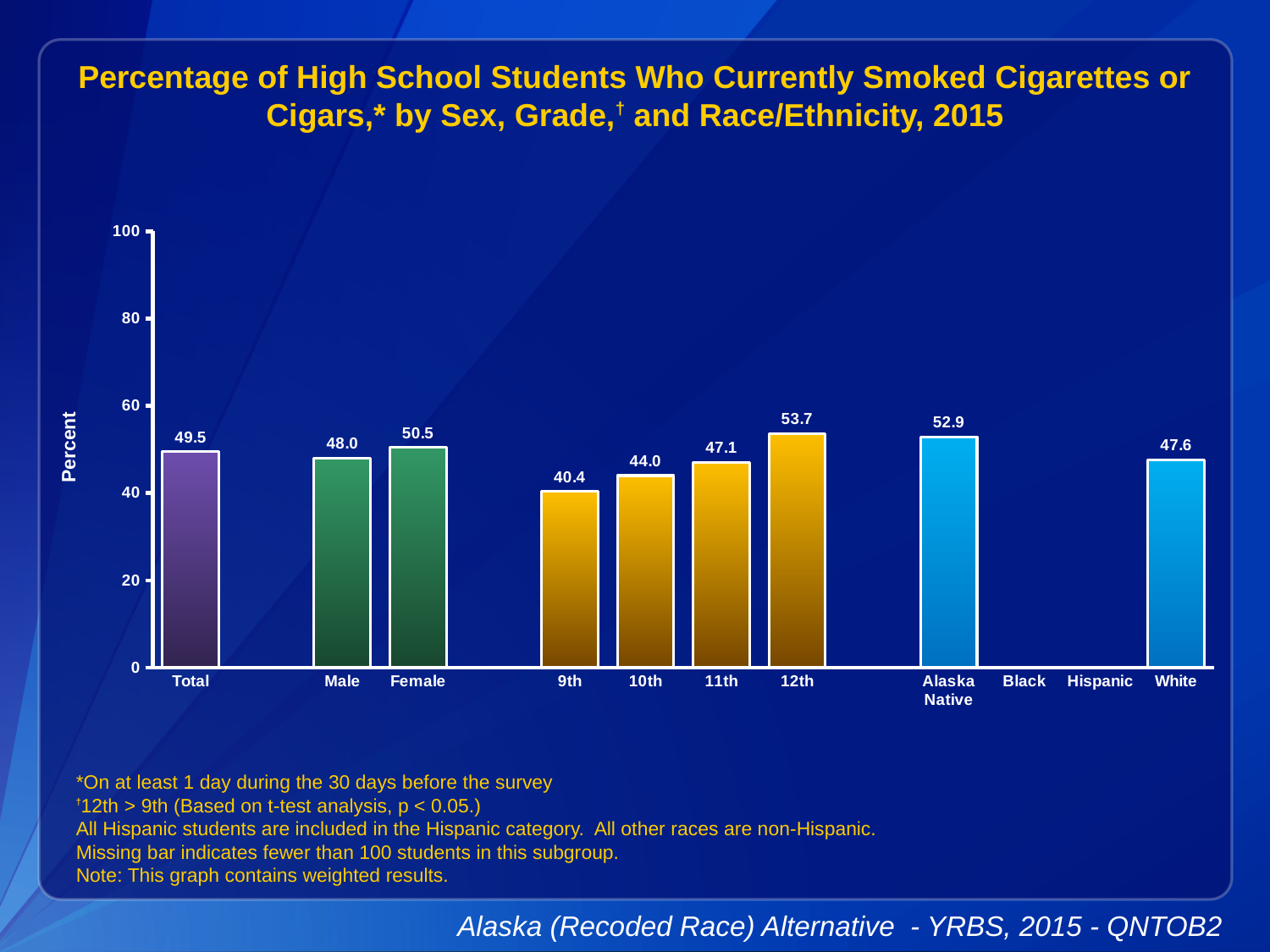
Do the values rise or fall from 9th grade to 12th grade? rise What is the value for Alaska Native? 52.9 How many bars are plotted on the chart? 9 Is the value for 11th grade greater or less than 40? greater Which is larger, the value for Male or the value for Female? Female Which category has the highest value? 12th What kind of chart is shown on the slide? bar chart What is the value for 9th grade? 40.4 What is the value for Total? 49.5 What is the difference between the values for 12th and 9th grade? 13.3 What is the value for Female? 50.5 Which category has the lowest value among the bars shown? 9th